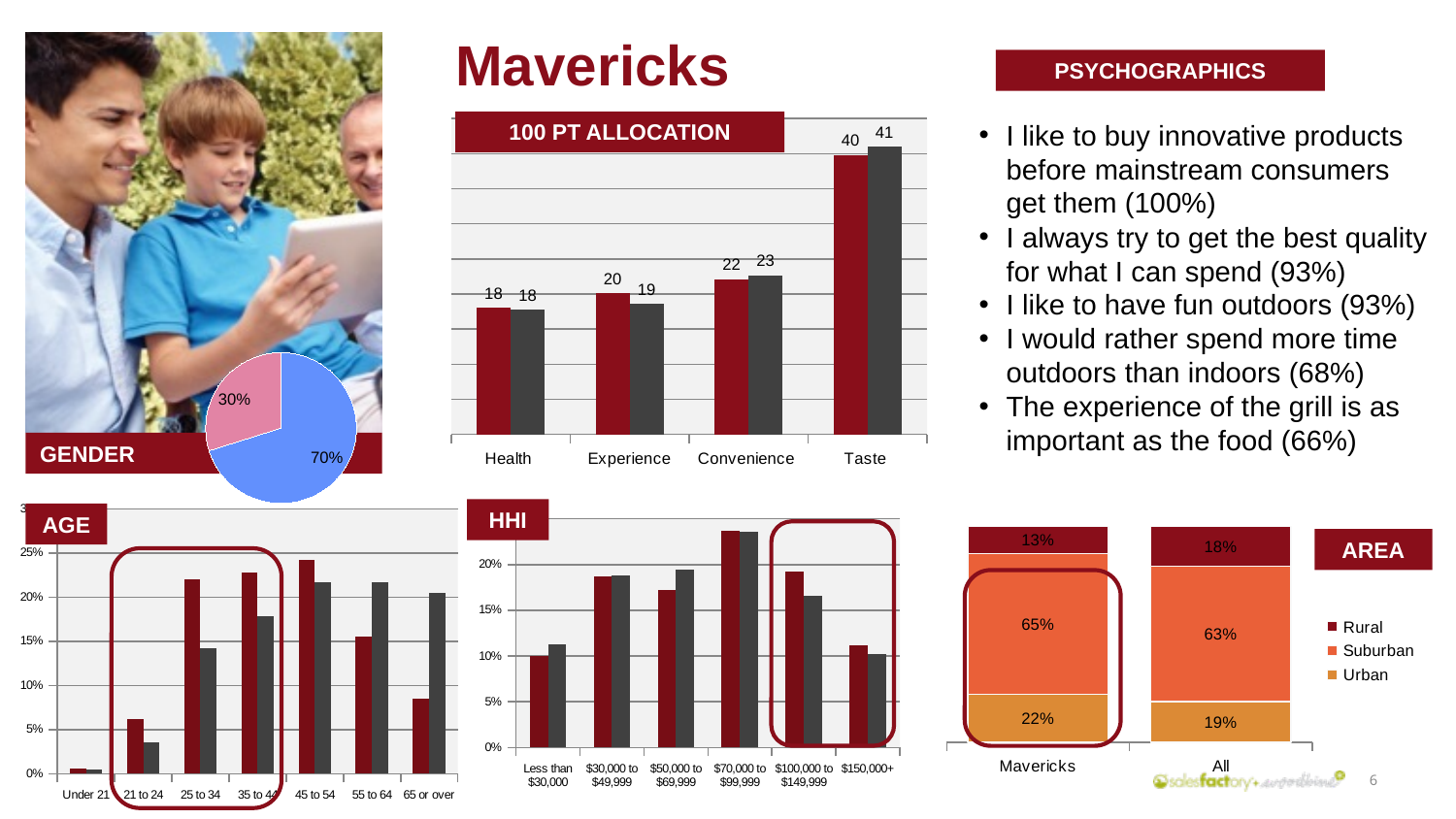
In the GENDER pie chart, what share does the larger slice represent? 70% How many income categories are shown on the x axis of the HHI chart? 6 In the HHI chart, is the red bar for Less than $30,000 greater or less than 15%? less What kind of chart is the AGE chart? Bar chart In the 100 PT ALLOCATION chart, what is the difference between the red bar for Taste (40) and the red bar for Health (18)? 22 In the AGE chart, is the red bar for 45 to 54 greater or less than 20%? greater In the 100 PT ALLOCATION chart, which category has the highest values? Taste In the AREA chart, what is the difference between the Urban share for Mavericks (22%) and for All (19%)? 3 percentage points In the AREA chart, what is the Suburban share for Mavericks? 65% In the 100 PT ALLOCATION chart, what value is labeled on the red bar for Taste? 40 How many series does the legend of the AREA chart list? 3 How many categories are shown on the x axis of the 100 PT ALLOCATION chart? 4